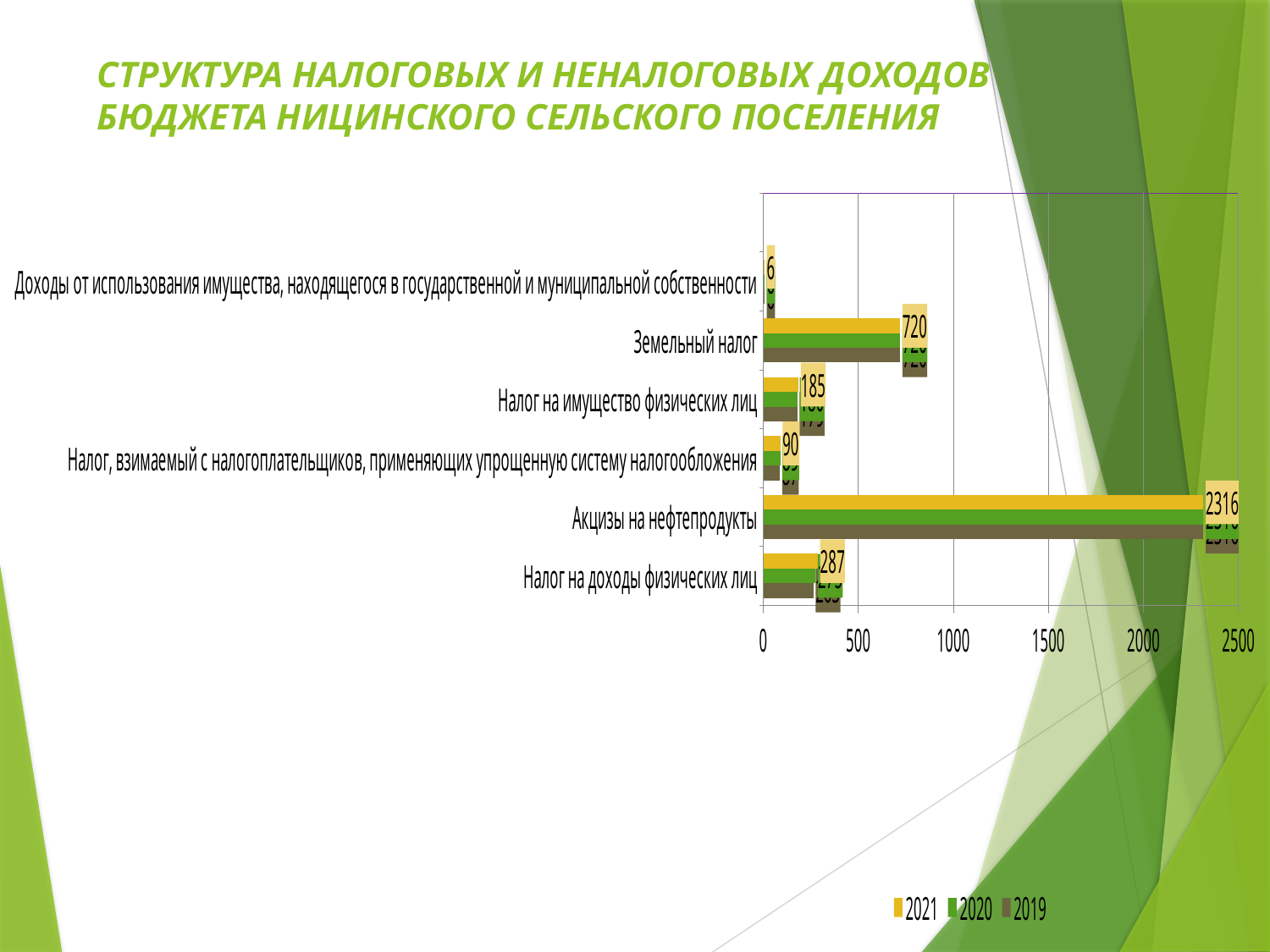
Which series is shown in yellow in the legend? 2021 Which category has the lowest 2021 value? Доходы от использования имущества, находящегося в государственной и муниципальной собственности Which is larger in 2021: Налог на имущество физических лиц or Налог, взимаемый с налогоплательщиков, применяющих упрощенную систему налогообложения? Налог на имущество физических лиц What is the difference between the 2021 values for Земельный налог and Налог на доходы физических лиц? 433 How many series does the legend list? 3 Which category has the highest 2021 value? Акцизы на нефтепродукты What kind of chart is shown on the slide? bar chart What is the 2021 value for Земельный налог? 720 How many categories are shown on the chart? 6 What is the 2021 value for Налог на доходы физических лиц? 287 What is the 2021 value for Акцизы на нефтепродукты? 2316 What is the 2021 value for Налог на имущество физических лиц? 185